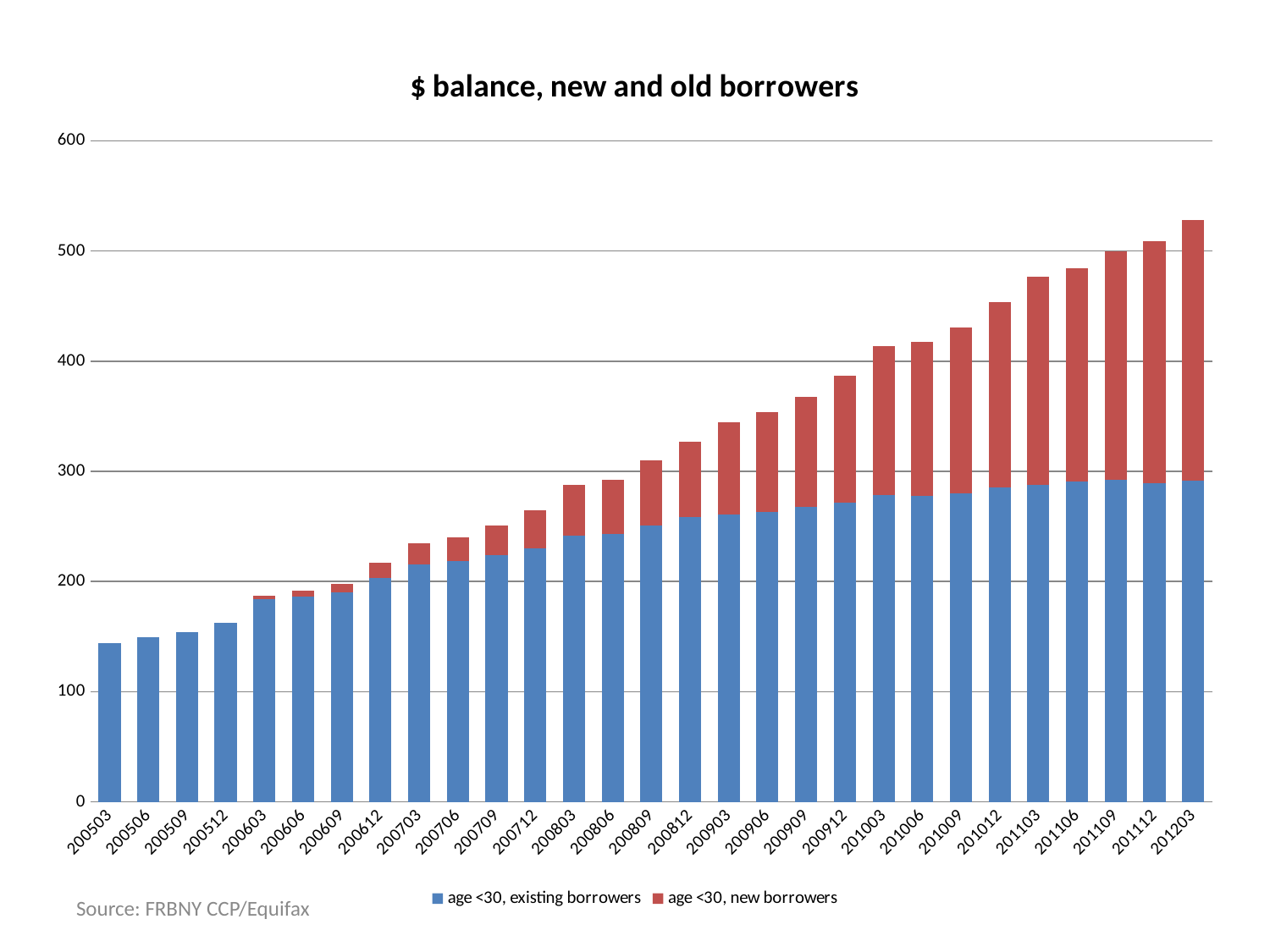
Which period has the lowest total bar? 200503 How many series does the legend list? 2 Is the total bar for 200503 greater or less than 200? less Do the total balances rise or fall from 200503 to 201203? rise Which is larger, the total bar for 201203 or the total bar for 200503? 201203 How many time periods (bars) are plotted along the x axis? 29 Is the total bar for 200812 greater or less than 300? greater What kind of chart is shown on the slide? stacked bar chart Is the total bar for 201003 greater or less than 400? greater What is the title of the chart? $ balance, new and old borrowers Which period has the highest total bar? 201203